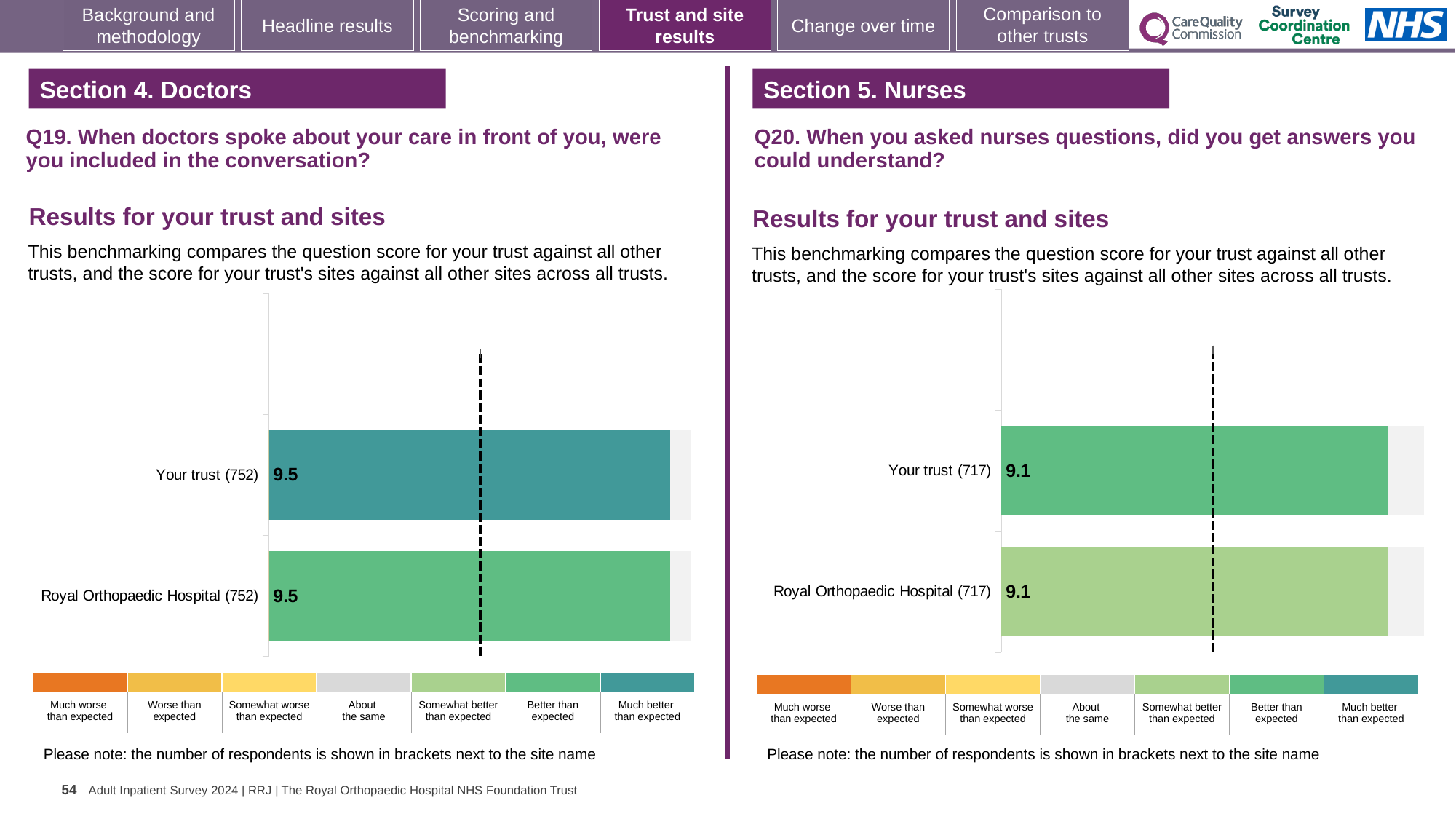
How many bars are plotted in the Q20 chart on the right? 2 In the Q19 chart on the left, what is the difference between the score for Your trust and the score for Royal Orthopaedic Hospital? 0 In the Q20 chart on the right, what is the score for Your trust? 9.1 In the Q19 chart on the left, what is the score for Your trust? 9.5 In the Q20 chart on the right, how many respondents are shown in brackets next to Royal Orthopaedic Hospital? 717 In the Q19 chart on the left, what is the score for Royal Orthopaedic Hospital? 9.5 In the Q20 chart on the right, what is the difference between the score for Your trust and the score for Royal Orthopaedic Hospital? 0 What kind of chart is used for the Q19 results on the left? Bar chart In the Q20 chart on the right, what is the score for Royal Orthopaedic Hospital? 9.1 In the Q20 chart on the right, which benchmark category does the colour of the Royal Orthopaedic Hospital bar correspond to in the legend? Somewhat better than expected In the Q19 chart on the left, how many respondents are shown in brackets next to Your trust? 752 How many bars are plotted in the Q19 chart on the left? 2